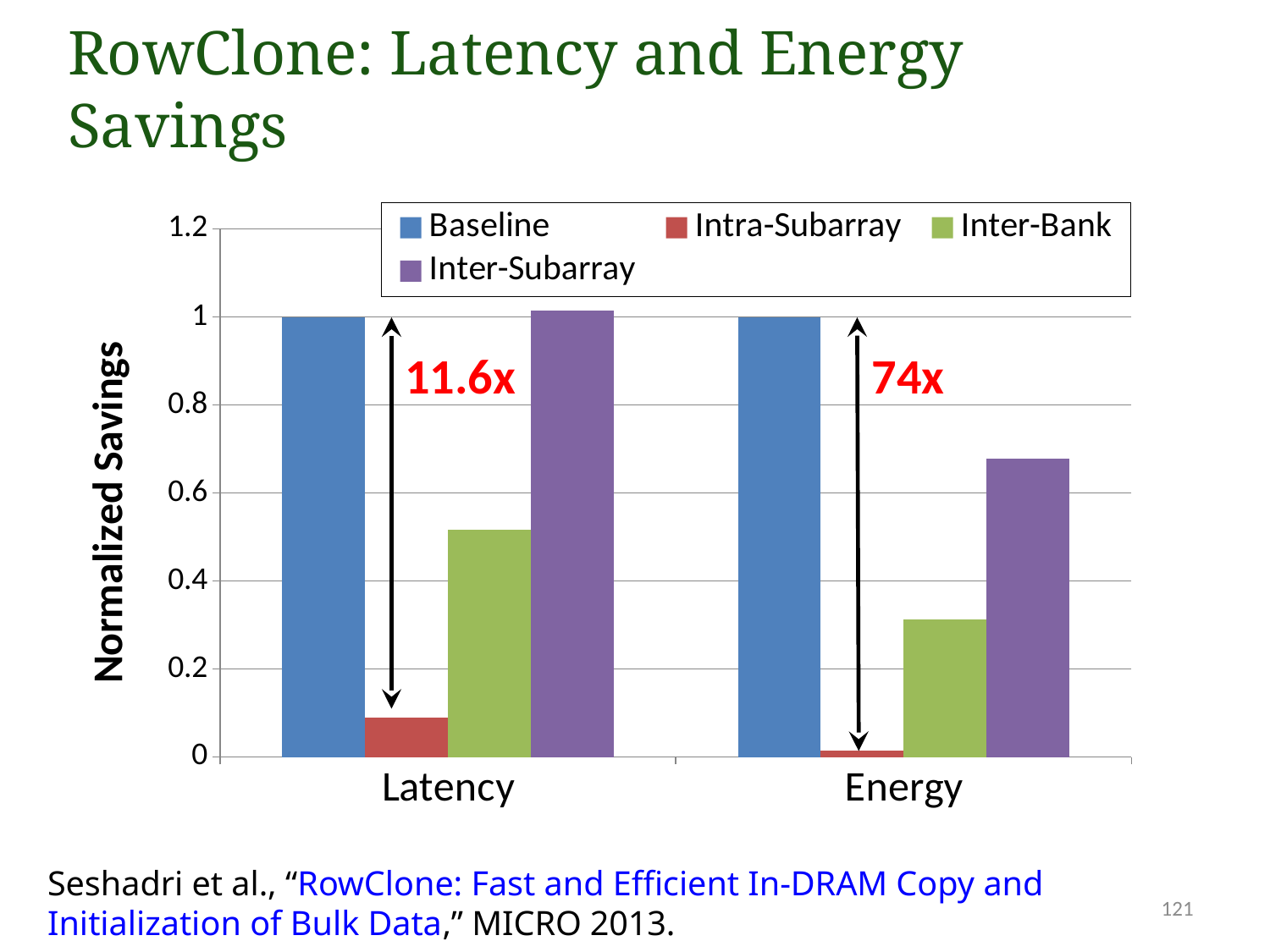
Is the Inter-Bank value for Energy greater or less than 0.4? less What kind of chart is shown on the slide? bar chart Is the Inter-Subarray value for Energy greater or less than 0.6? greater How many series does the legend list? 4 Is the Inter-Subarray value larger for Latency or for Energy? Latency Is the Intra-Subarray value for Latency greater or less than 0.2? less What is the Baseline value for Latency? 1 What is the title of the y axis? Normalized Savings How many categories are shown on the x axis? 2 What is the Baseline value for Energy? 1 Which series has the lowest value for Energy? Intra-Subarray